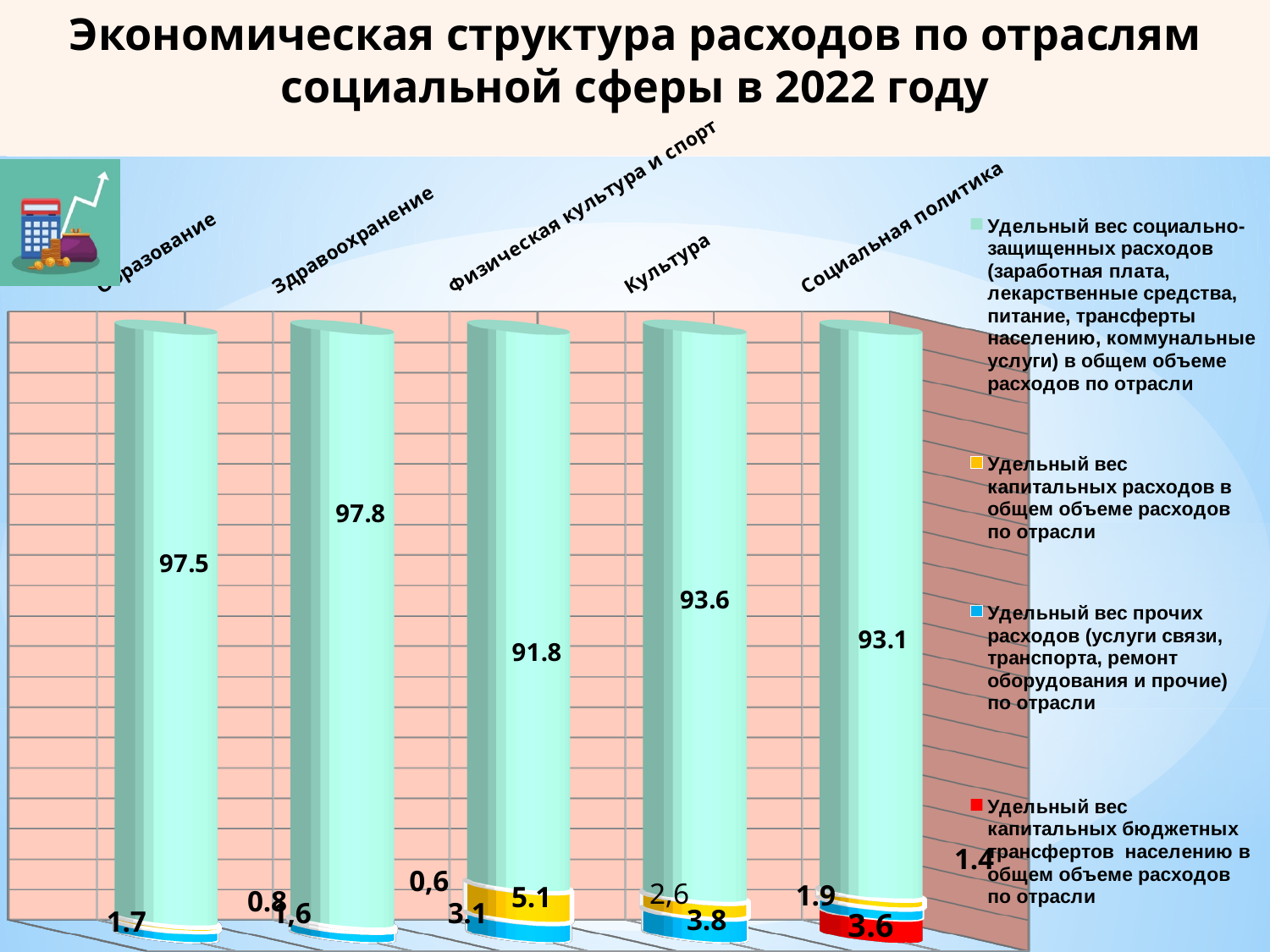
What kind of chart is shown on the slide? Stacked bar chart What is the value of the share of socially protected expenditures for Социальная политика? 93.1 What is the difference between the share of socially protected expenditures for Здравоохранение and for Физическая культура и спорт? 6.0 What is the value of the share of socially protected expenditures for Здравоохранение? 97.8 What is the value of the share of socially protected expenditures (Удельный вес социально-защищенных расходов) for Образование? 97.5 How many categories (industries) are shown on the chart? 5 Which is larger: the share of socially protected expenditures for Культура or for Социальная политика? Культура Which category has the lowest share of socially protected expenditures? Физическая культура и спорт What is the value of the share of capital budget transfers to the population (red segment) for Социальная политика? 3.6 How many series does the legend list? 4 What is the value of the share of socially protected expenditures for Физическая культура и спорт? 91.8 Which category has the highest share of socially protected expenditures? Здравоохранение